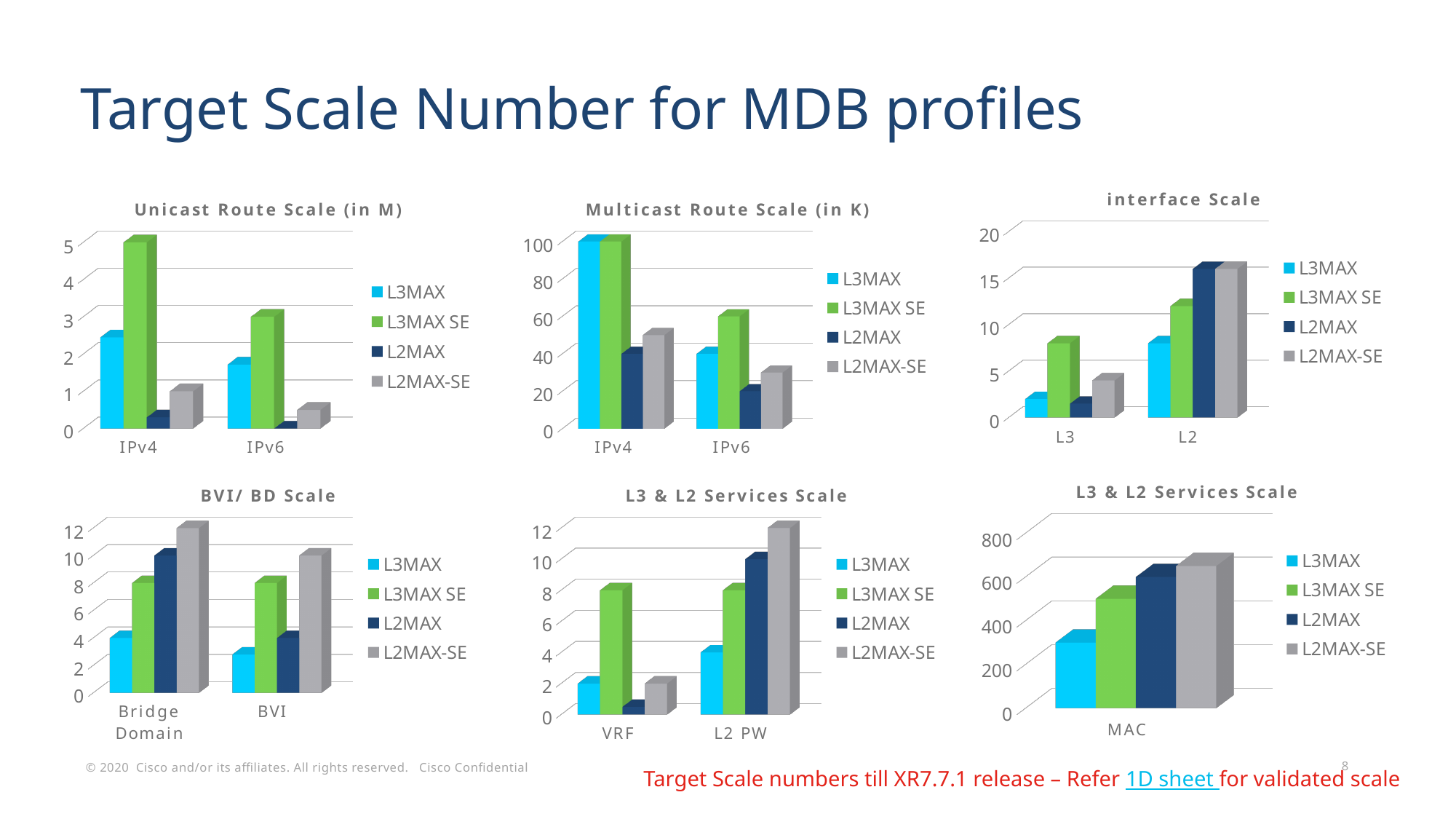
In the Unicast Route Scale (in M) chart, is the L3MAX SE value for IPv4 greater or less than 4? greater In the BVI/ BD Scale chart, which series has the highest value for Bridge Domain? L2MAX-SE In the interface Scale chart, is the L3MAX SE value for L3 greater or less than 5? greater In the Unicast Route Scale (in M) chart, which series has the lowest value for IPv6? L2MAX How many series does the legend of the Unicast Route Scale (in M) chart list? 4 In the interface Scale chart, which category has the larger L3MAX value, L3 or L2? L2 In the Unicast Route Scale (in M) chart, which series has the highest value for IPv4? L3MAX SE In the L3 & L2 Services Scale chart with VRF and L2 PW, which series has the lowest value for VRF? L2MAX In the L3 & L2 Services Scale chart for MAC, is the L3MAX value greater or less than 400? less In the Multicast Route Scale (in K) chart, which series has the lowest value for IPv4? L2MAX How many categories are shown on the x axis of the interface Scale chart? 2